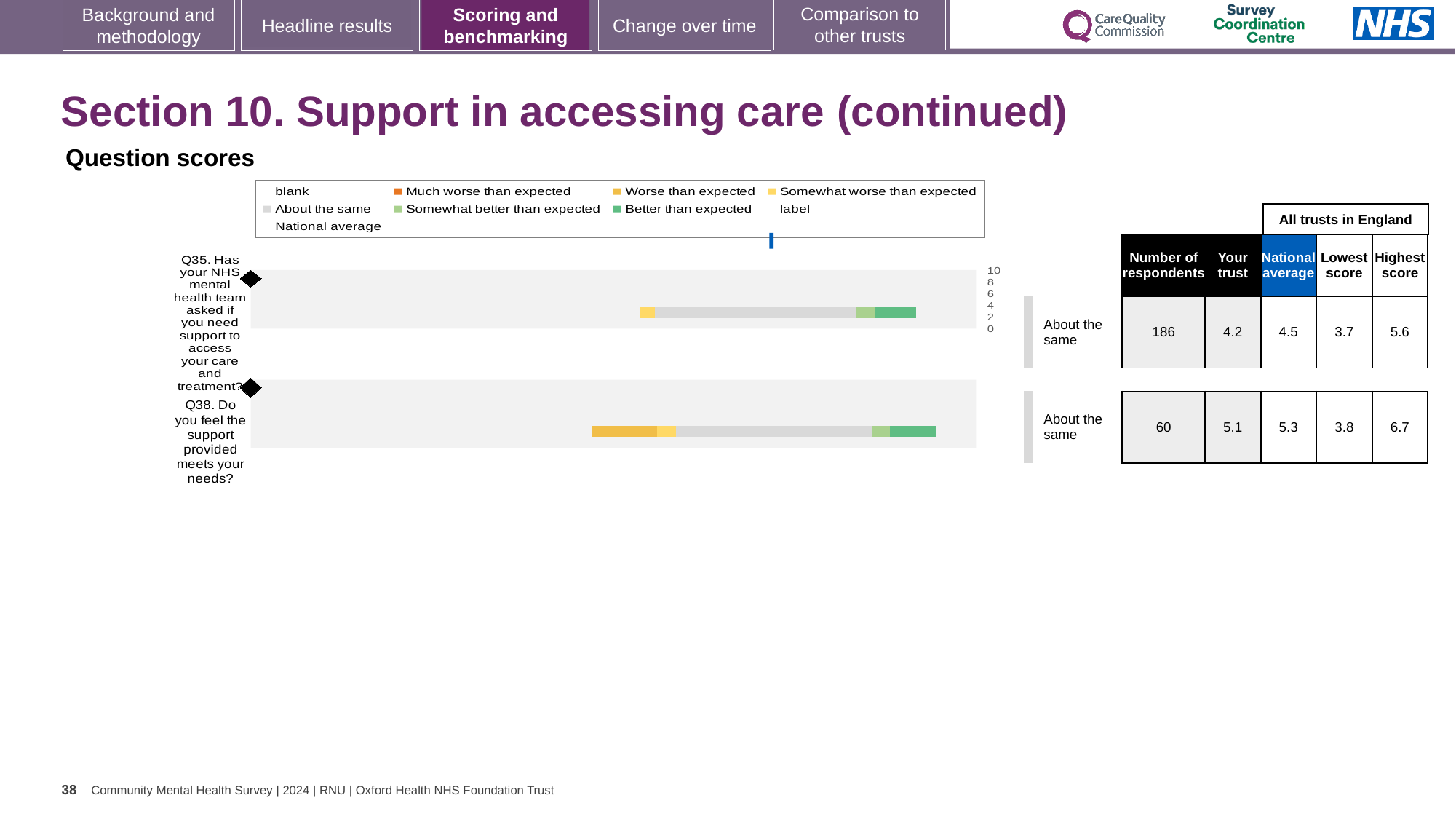
What is the national average for Q38 in the question scores chart? 5.3 How many questions are plotted in the question scores chart? 2 By how much does the national average for Q35 exceed the 'Your trust' score for Q35? 0.3 What benchmark category is shown for Q35 in the question scores chart? About the same In the legend of the question scores chart, what colour represents 'Better than expected'? green What kind of chart is used to show the question scores? bar chart How many respondents answered Q38 according to the question scores chart? 60 How many respondents answered Q35 according to the question scores chart? 186 What is the 'Your trust' score for Q35 in the question scores chart? 4.2 What is the difference between the highest score and the lowest score for Q38? 2.9 Which question has the higher 'Your trust' score, Q35 or Q38? Q38 What is the lowest score across all trusts in England for Q35? 3.7